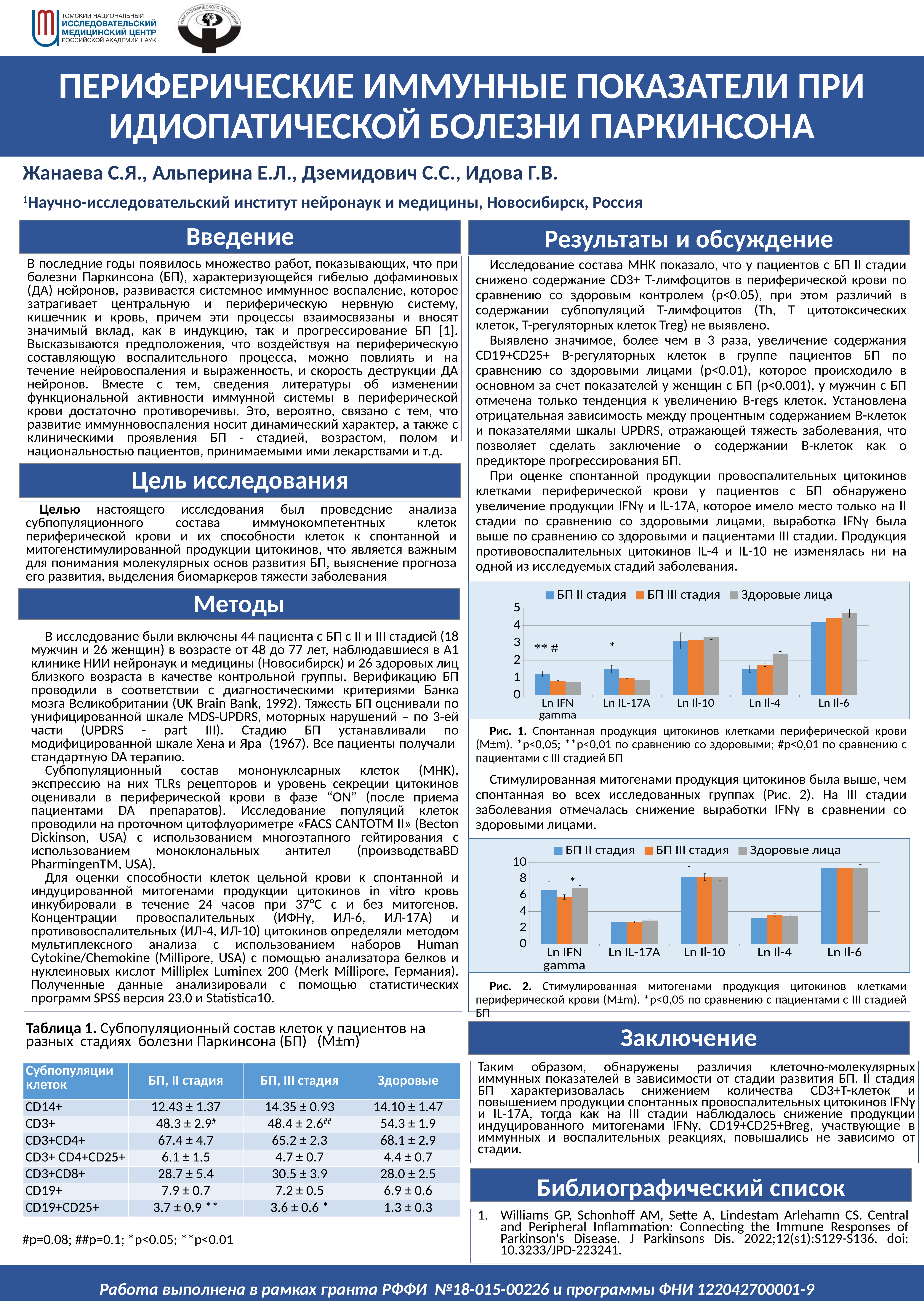
In the chart in Рис. 2, at Ln IFN gamma, which is larger: БП II стадия or БП III стадия? БП II стадия In the chart in Рис. 1, which category has the highest value for БП II стадия? Ln Il-6 In the chart in Рис. 1, what is the first entry in the legend? БП II стадия In the chart in Рис. 1, is the value for Здоровые лица at Ln Il-6 greater or less than 4? greater In the chart in Рис. 1 (spontaneous cytokine production), what kind of chart is shown? bar chart In the chart in Рис. 2, is the value for БП II стадия at Ln Il-6 greater or less than 8? greater In the chart in Рис. 1, how many cytokine categories are shown on the x axis? 5 In the chart in Рис. 1, is the value for БП II стадия at Ln IFN gamma greater or less than 2? less In the chart in Рис. 2, which category has the lowest value for Здоровые лица? Ln IL-17A In the chart in Рис. 1, how many series does the legend list? 3 In the chart in Рис. 2 (mitogen-stimulated cytokine production), what kind of chart is shown? bar chart In the chart in Рис. 1, at Ln Il-4, which is larger: БП II стадия or Здоровые лица? Здоровые лица